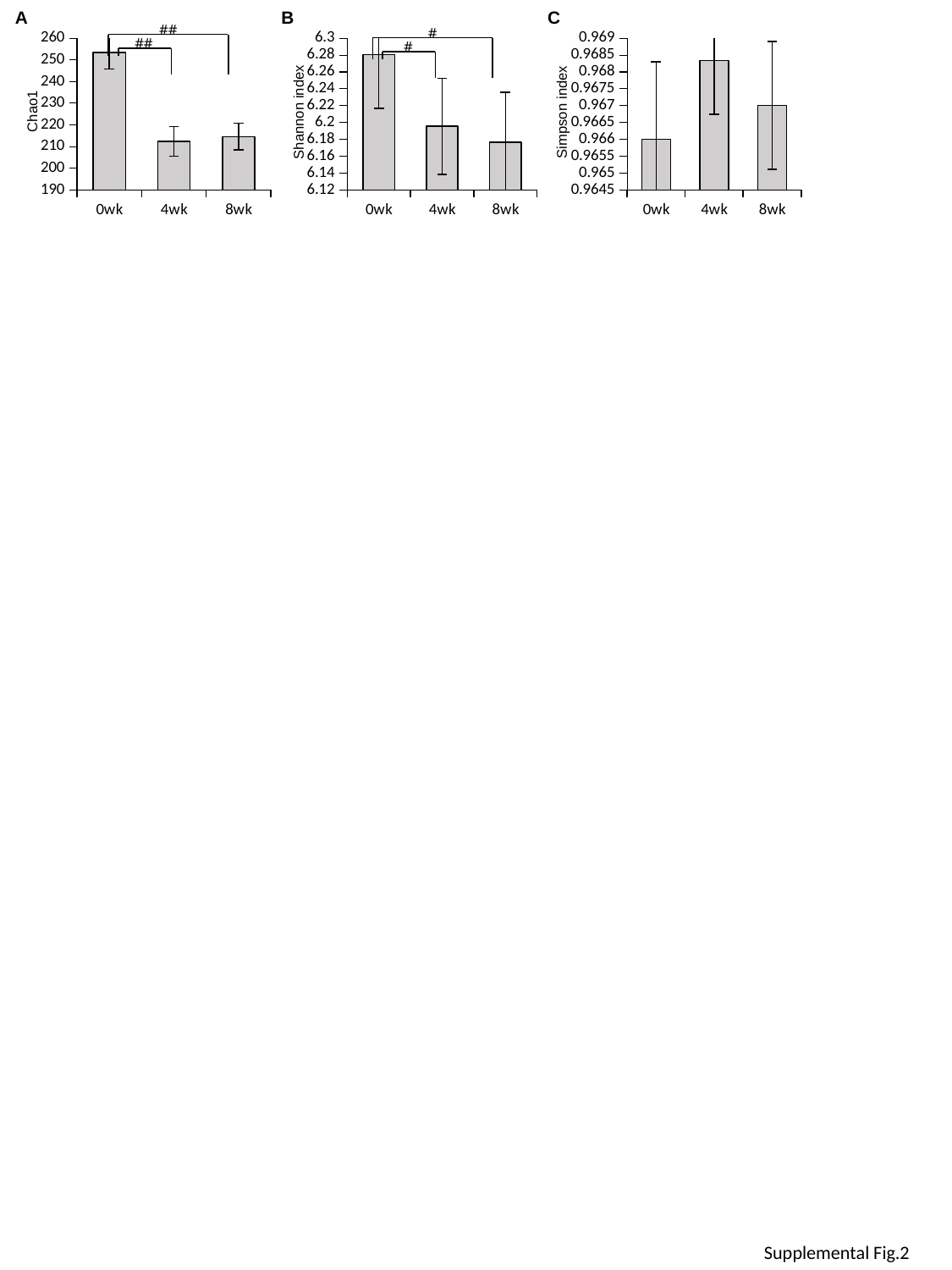
How many categories are shown on the x axis of chart B (Shannon index)? 3 In chart A (Chao1), is the value for 0wk greater or less than 240? greater What kind of chart is chart A (Chao1)? bar chart In chart B (Shannon index), is the value for 8wk greater or less than 6.2? less In chart C (Simpson index), which category has the highest value? 4wk In chart A (Chao1), which is larger, the value for 0wk or the value for 4wk? 0wk In chart A (Chao1), which category has the highest value? 0wk In chart B (Shannon index), which category has the highest value? 0wk What is the y-axis label of chart B? Shannon index In chart A (Chao1), is the value for 4wk greater or less than 220? less In chart C (Simpson index), which category has the lowest value? 0wk